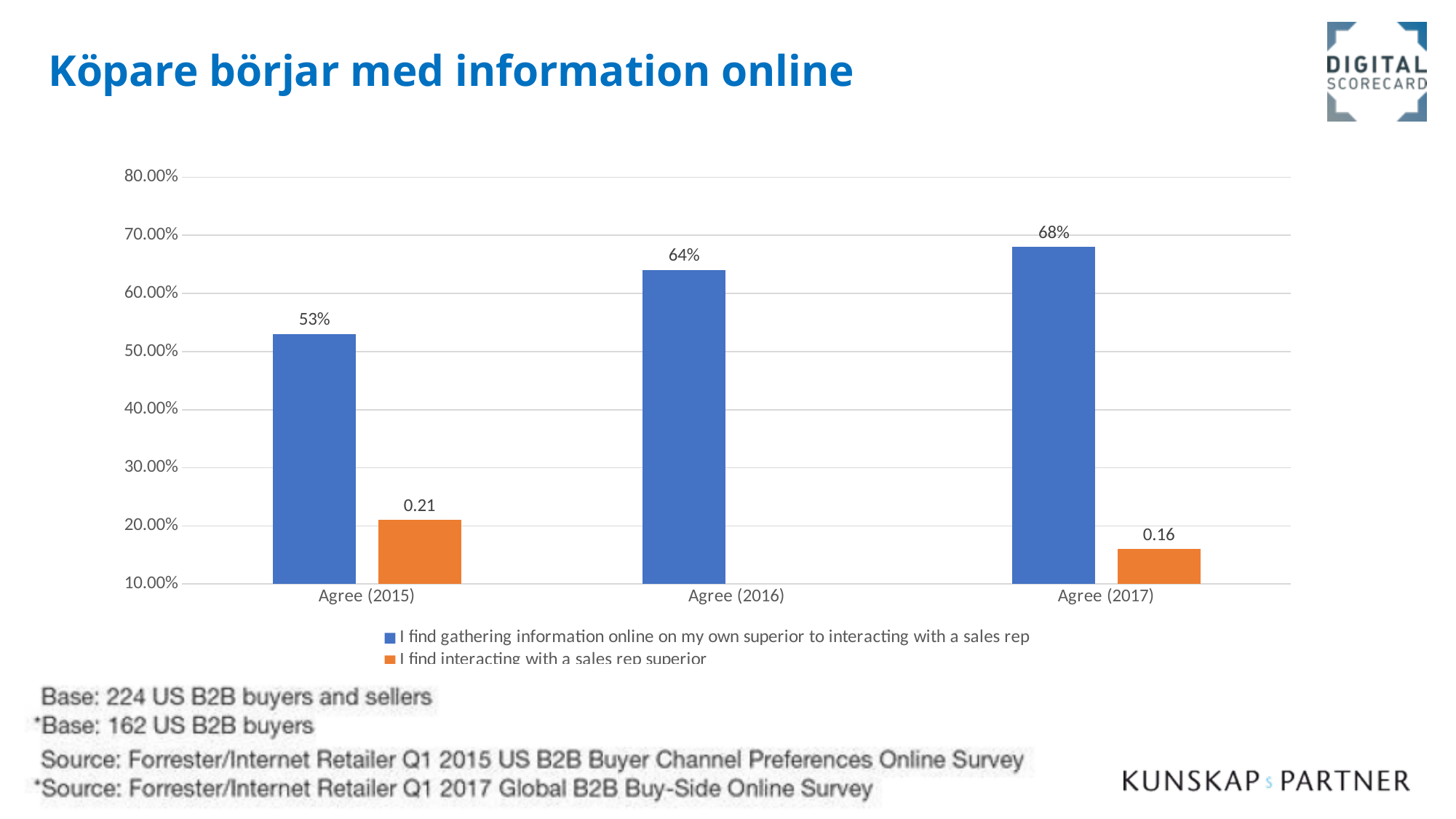
In which category is the blue series highest? Agree (2017) Do the blue bar values rise or fall from Agree (2015) to Agree (2017)? rise Which is larger: the blue bar for Agree (2016) or the blue bar for Agree (2015)? Agree (2016) What is the value for 'I find gathering information online on my own superior to interacting with a sales rep' in Agree (2017)? 68% What is the data label on the orange bar for Agree (2017)? 0.16 What is the value for 'I find gathering information online on my own superior to interacting with a sales rep' in Agree (2016)? 64% How many series does the legend list? 2 What is the data label on the orange bar for Agree (2015)? 0.21 In which category is the blue series lowest? Agree (2015) What is the value for 'I find gathering information online on my own superior to interacting with a sales rep' in Agree (2015)? 53% What kind of chart is shown on the slide? bar chart What is the difference between the blue bar values for Agree (2017) and Agree (2015)? 15%